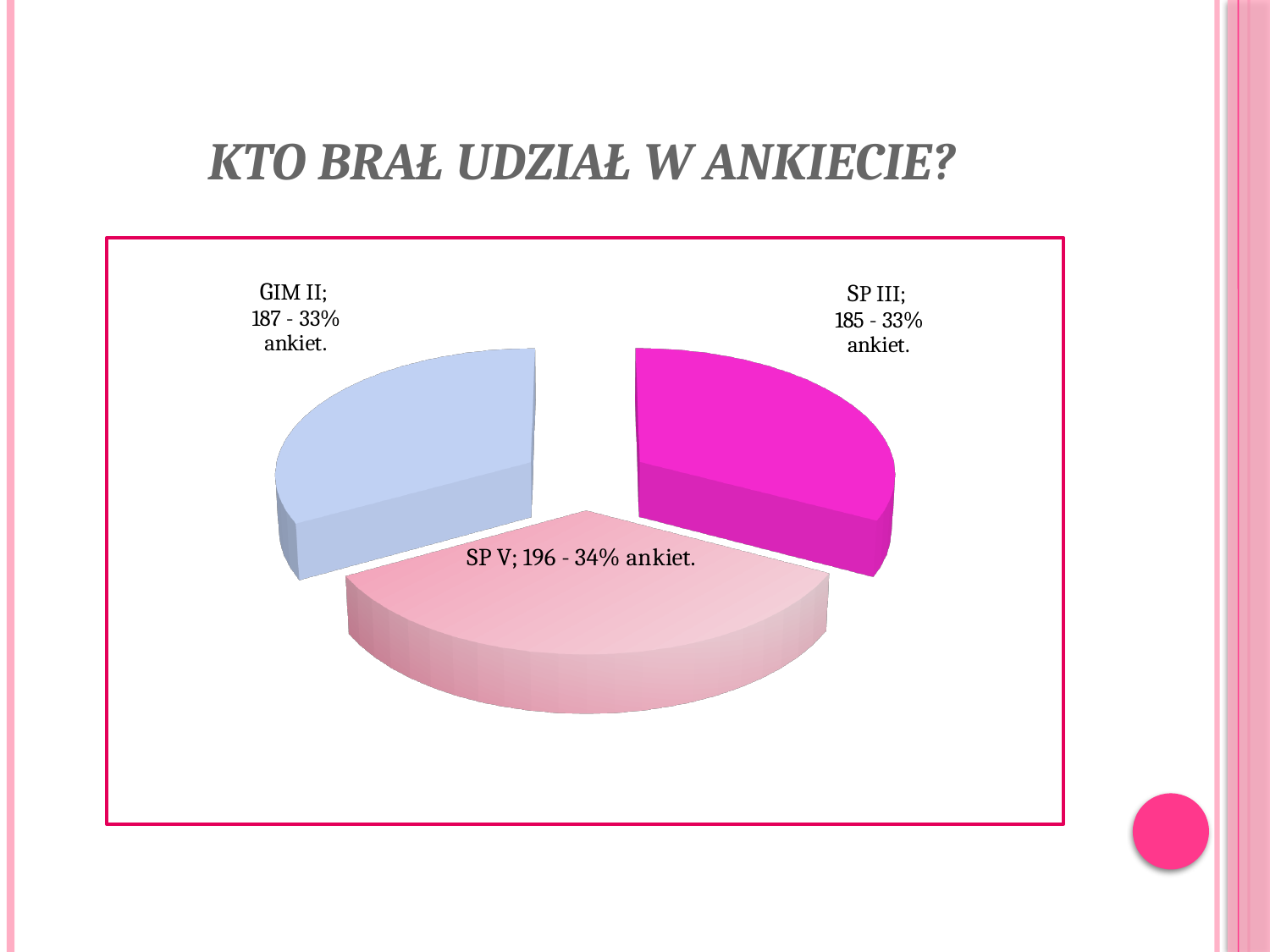
How many surveys (ankiet) does the SP V slice represent? 196 How many surveys (ankiet) does the SP III slice represent? 185 Which category has the largest slice of the pie? SP V What is the difference in the number of surveys between SP V and SP III? 11 How many slices does the pie chart have? 3 Which has more surveys, GIM II or SP III? GIM II What percentage share of the pie does GIM II have? 33% How many surveys (ankiet) does the GIM II slice represent? 187 What is the title of the slide containing the pie chart? KTO BRAŁ UDZIAŁ W ANKIECIE? What percentage share of the pie does SP V have? 34% What type of chart is shown on the slide? pie chart Which category has the smallest number of surveys? SP III